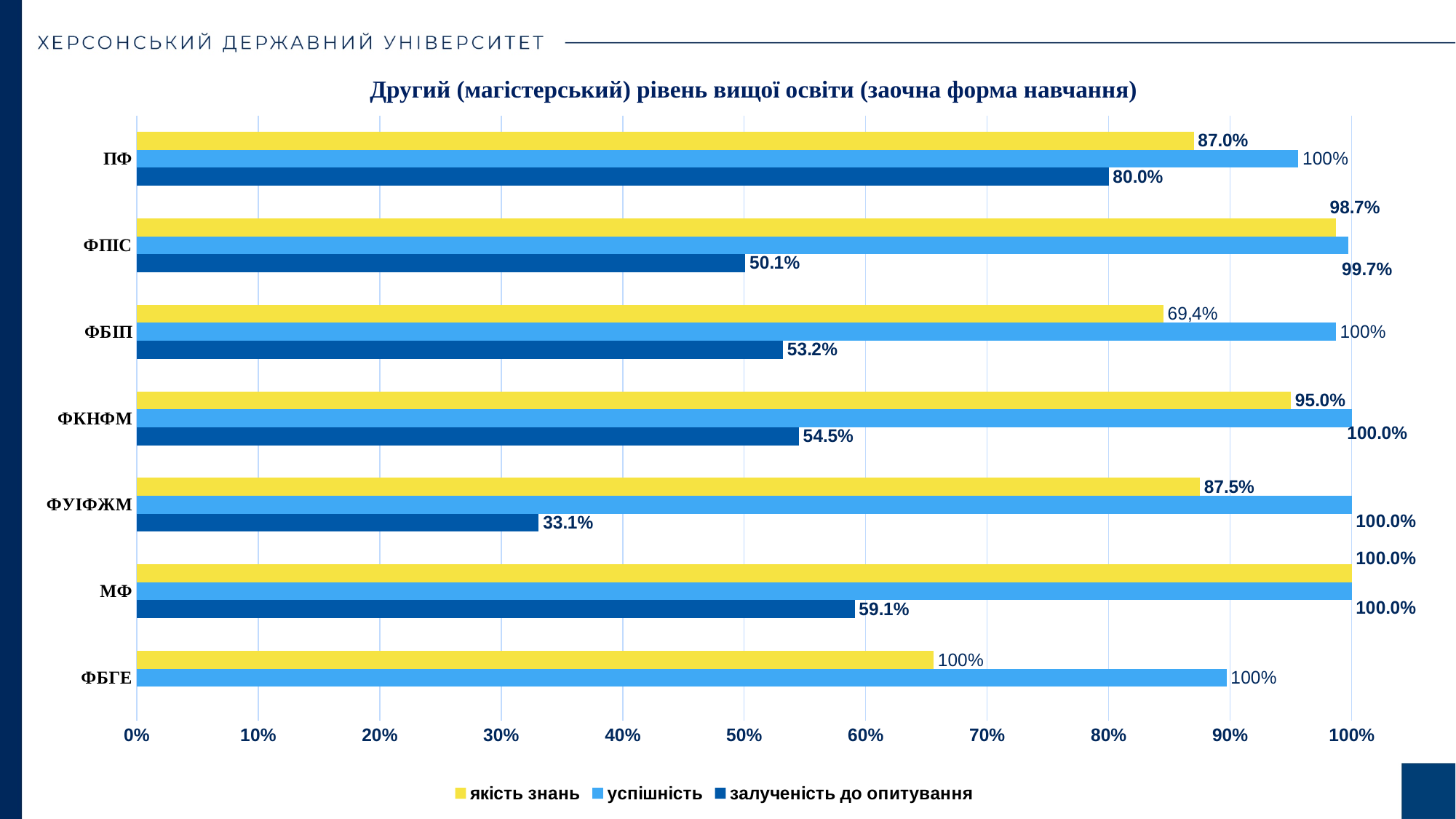
How many series does the legend list? 3 Is the value of залученість до опитування for ФУІФЖМ greater or less than 40%? less Which is larger: залученість до опитування for ПФ or for ФПІС? ПФ What is the value of залученість до опитування for ПФ? 80.0% What is the value of якість знань for ФПІС? 98.7% What type of chart is shown on the slide? bar chart What is the value of якість знань for ФКНФМ? 95.0% Which category has the lowest value for залученість до опитування? ФУІФЖМ What is the value of залученість до опитування for ФУІФЖМ? 33.1% How many categories are shown on the vertical axis? 7 Which category has the highest value for залученість до опитування? ПФ What is the difference between the залученість до опитування values for ПФ and ФУІФЖМ? 46.9%